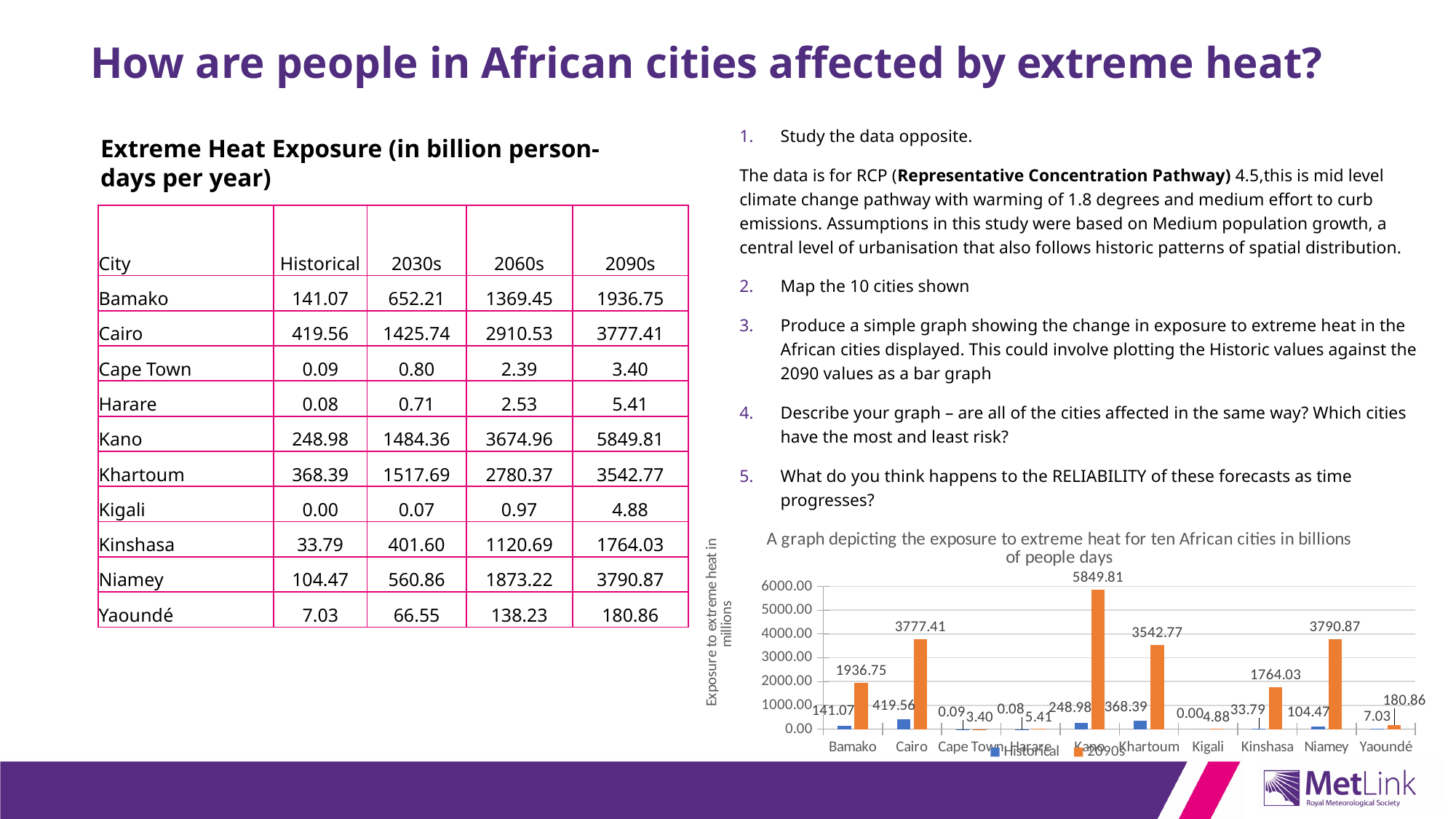
What is the Historical value for Cairo in the chart? 419.56 What is the y-axis label of the chart? Exposure to extreme heat in millions Which city has the lowest Historical value in the chart? Kigali How many series does the chart's legend list? 2 Is the 2090s value for Kinshasa in the chart greater or less than 2000.00? less How many cities are plotted on the x axis of the chart? 10 Which city has the highest 2090s value in the chart? Kano What is the 2090s value for Kano in the chart? 5849.81 What kind of chart is shown on the slide? bar chart Which is larger in the chart: the 2090s value for Cairo or the 2090s value for Khartoum? Cairo What is the difference between the 2090s and Historical values for Bamako in the chart? 1795.68 What is the 2090s value for Niamey in the chart? 3790.87